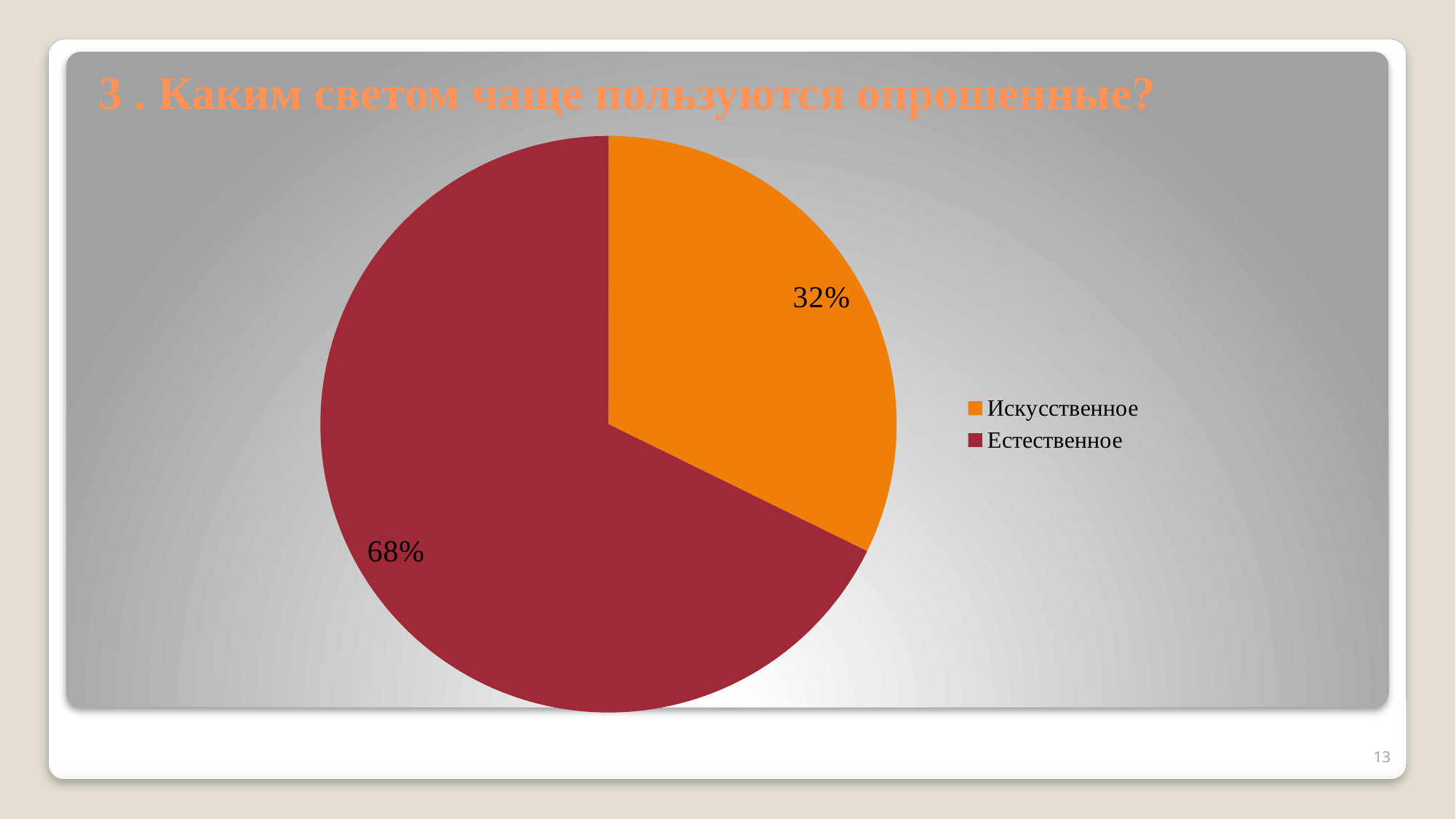
What share of the pie does Искусственное have? 32% How many slices does the pie chart have? 2 What share of the pie does Естественное have? 68% Which is larger, the slice for Искусственное or the slice for Естественное? Естественное What kind of chart is shown on the slide? pie chart How many entries does the legend list? 2 What is the title of the chart? 3 . Каким светом чаще пользуются опрошенные? What colour is the slice for Искусственное? orange Which category has the largest slice of the pie? Естественное Which category has the smallest slice of the pie? Искусственное What is the difference in percentage points between Естественное and Искусственное? 36